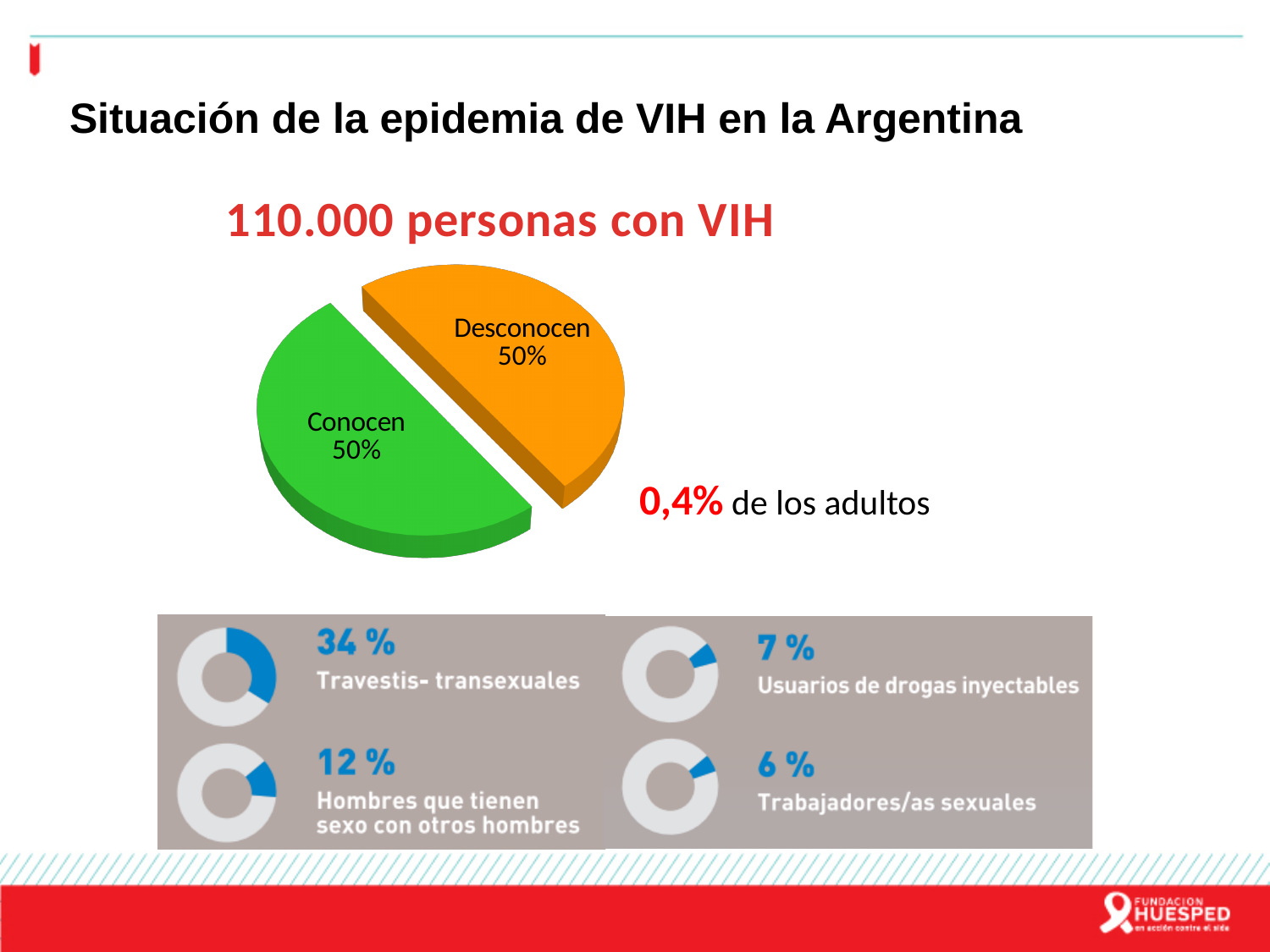
In the infographic at the bottom of the slide, what is the difference between the percentage for 'Travestis- transexuales' and the percentage for 'Hombres que tienen sexo con otros hombres'? 22 % How many slices does the pie chart have? 2 In the infographic at the bottom of the slide, what percentage is shown for 'Travestis- transexuales'? 34 % What kind of chart is shown under the heading '110.000 personas con VIH'? pie chart In the infographic at the bottom of the slide, what percentage is shown for 'Usuarios de drogas inyectables'? 7 % In the pie chart, what share is labelled 'Conocen'? 50% In the pie chart, what share is labelled 'Desconocen'? 50% In the pie chart, what colour is the 'Desconocen' slice? orange In the infographic at the bottom of the slide, which group has the highest percentage? Travestis- transexuales In the infographic at the bottom of the slide, what percentage is shown for 'Hombres que tienen sexo con otros hombres'? 12 % In the infographic at the bottom of the slide, which group has the lowest percentage? Trabajadores/as sexuales In the pie chart, what colour is the 'Conocen' slice? green